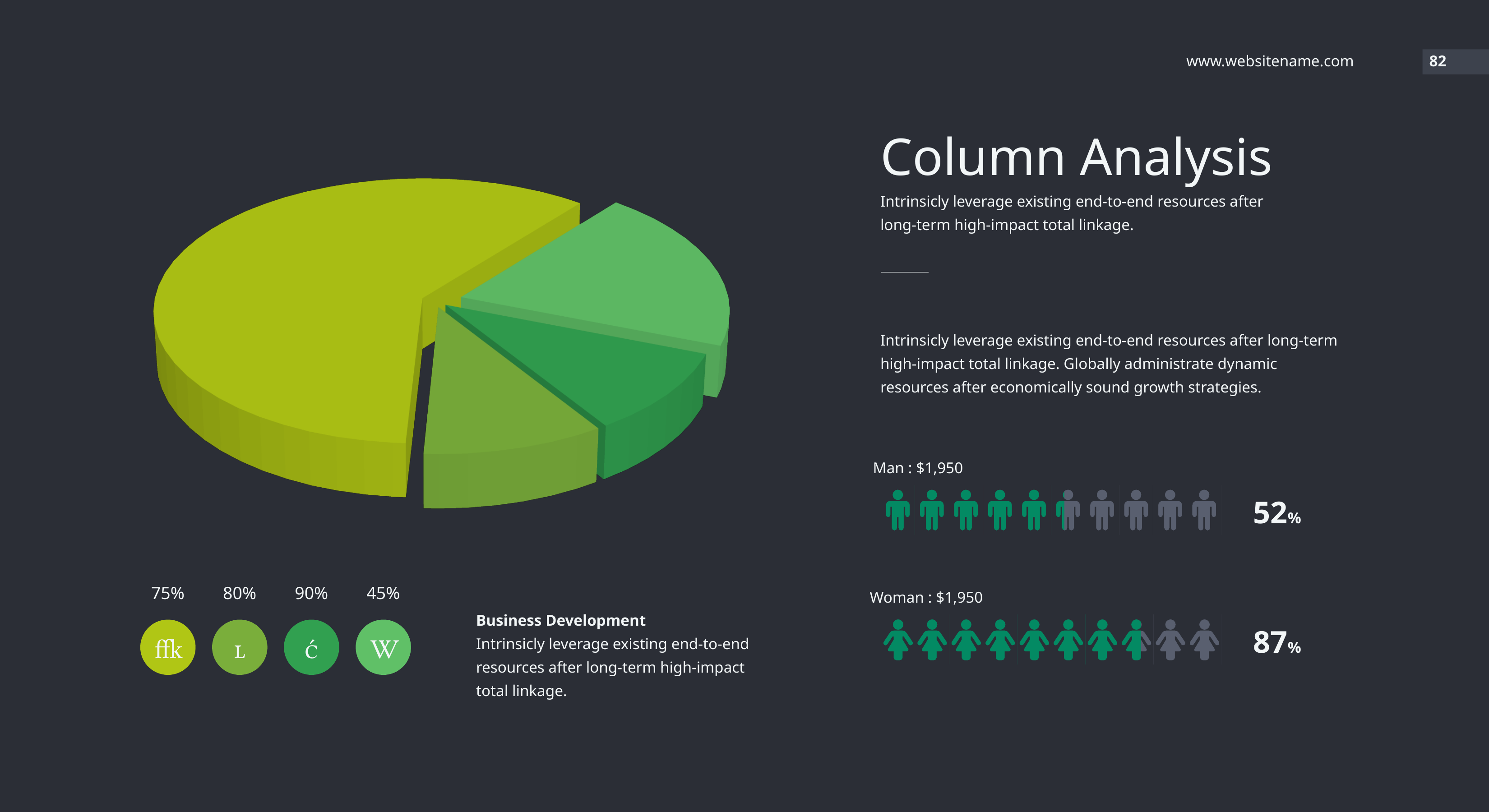
What kind of chart is shown on the left of the slide? pie chart In the pictogram on the right, what percentage is shown for Man? 52% In the row of circle icons below the pie chart, what percentage is shown above the 'W' circle? 45% Does the pie chart on the left have data labels printed on its slices? No Does the pie chart on the left show a legend? No In the pictogram on the right, what is the difference between the Woman percentage and the Man percentage? 35% In the pictogram on the right, which has the larger percentage, Man or Woman? Woman How many slices does the pie chart on the left have? 4 In the pictogram on the right, what dollar value is shown next to Man? $1,950 Which slice of the pie chart on the left is the largest? the yellow-green slice In the row of circle icons below the pie chart, which icon has the highest percentage? ć (90%) In the pictogram on the right, what percentage is shown for Woman? 87%